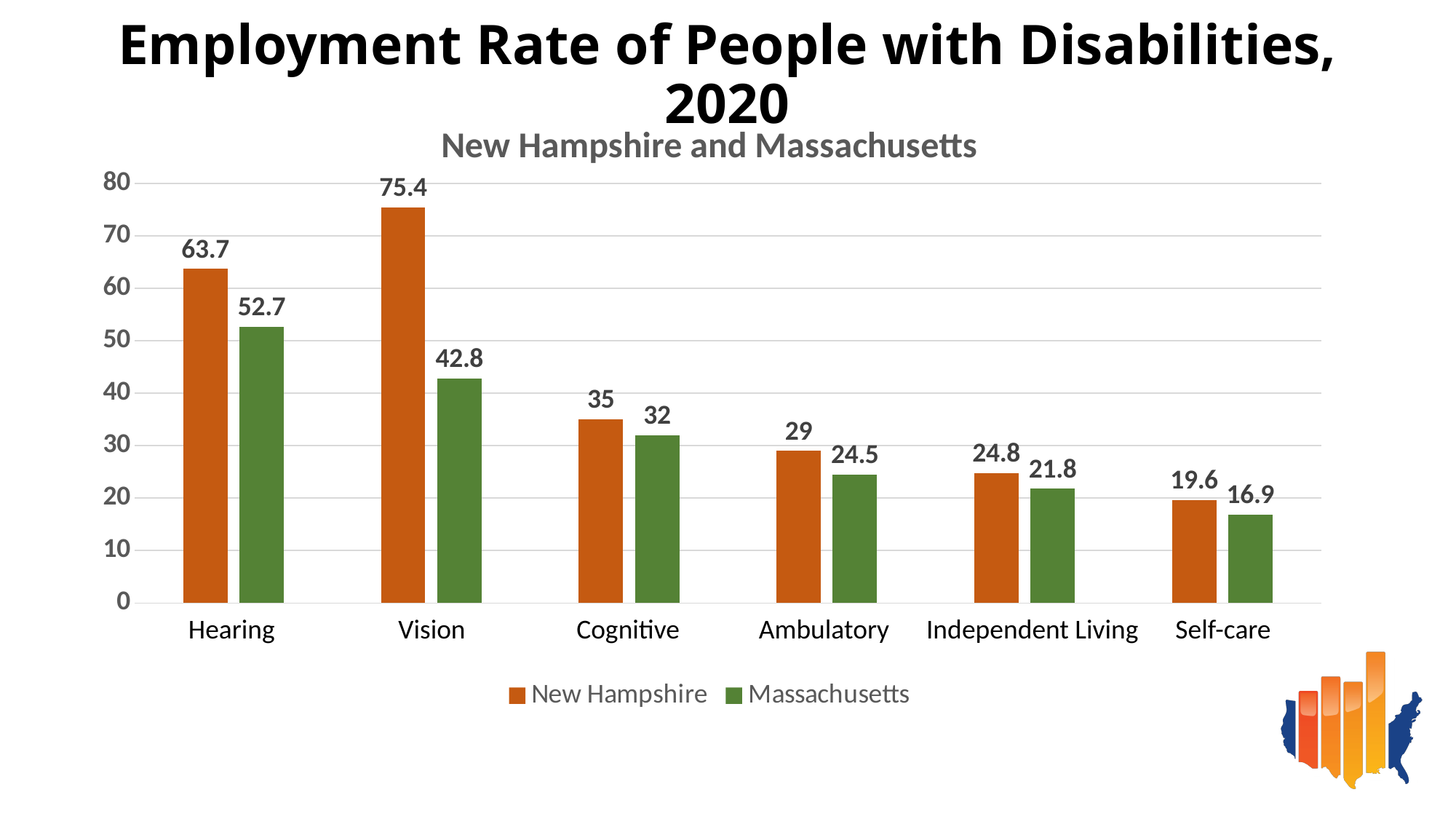
Which is larger, the Massachusetts employment rate for Hearing or for Vision? Hearing Which category has the lowest employment rate for Massachusetts? Self-care How many series does the legend list? 2 What is the employment rate for Massachusetts in the Self-care category? 16.9 Which category has the highest employment rate for New Hampshire? Vision What kind of chart is shown on the slide? Bar chart What is the employment rate for Massachusetts in the Hearing category? 52.7 How many disability categories are shown on the x axis? 6 Is the New Hampshire employment rate for Ambulatory greater or less than 20? greater What is the difference between the New Hampshire and Massachusetts employment rates in the Vision category? 32.6 What is the employment rate for New Hampshire in the Vision category? 75.4 What is the difference between the New Hampshire and Massachusetts employment rates in the Cognitive category? 3